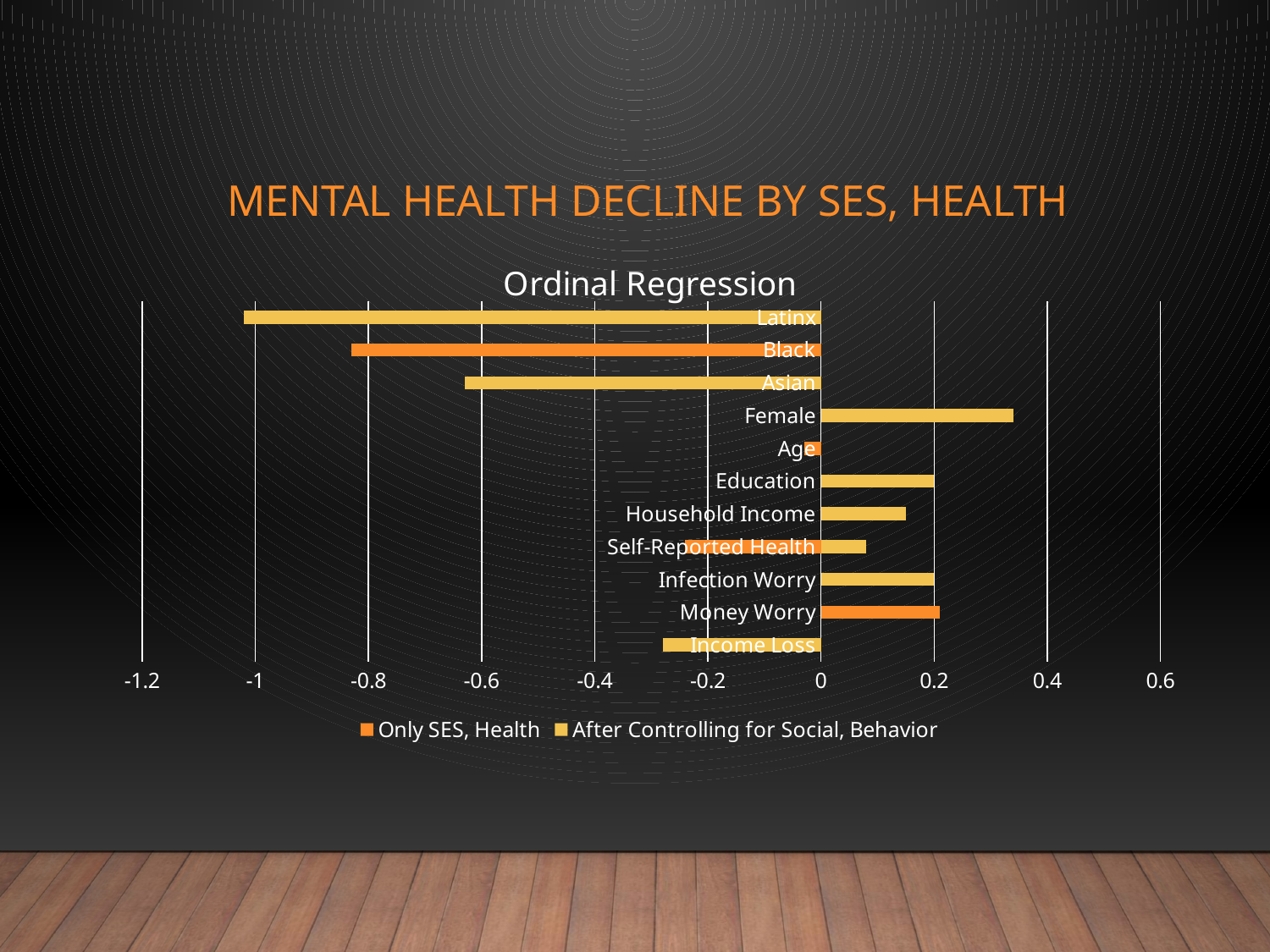
What kind of chart is shown on the slide? Bar chart Is the value for Asian greater or less than -0.4? less How many series does the legend list? 2 Is the value for Income Loss greater or less than -0.2? less What is the title of the chart? Ordinal Regression Which is larger, the value for Female or the value for Household Income? Female Which category has the highest value? Female How many categories are shown on the chart? 11 Is the value for Female greater or less than 0.2? greater Which category has the lowest (most negative) value? Latinx What are the two series named in the legend? Only SES, Health; After Controlling for Social, Behavior